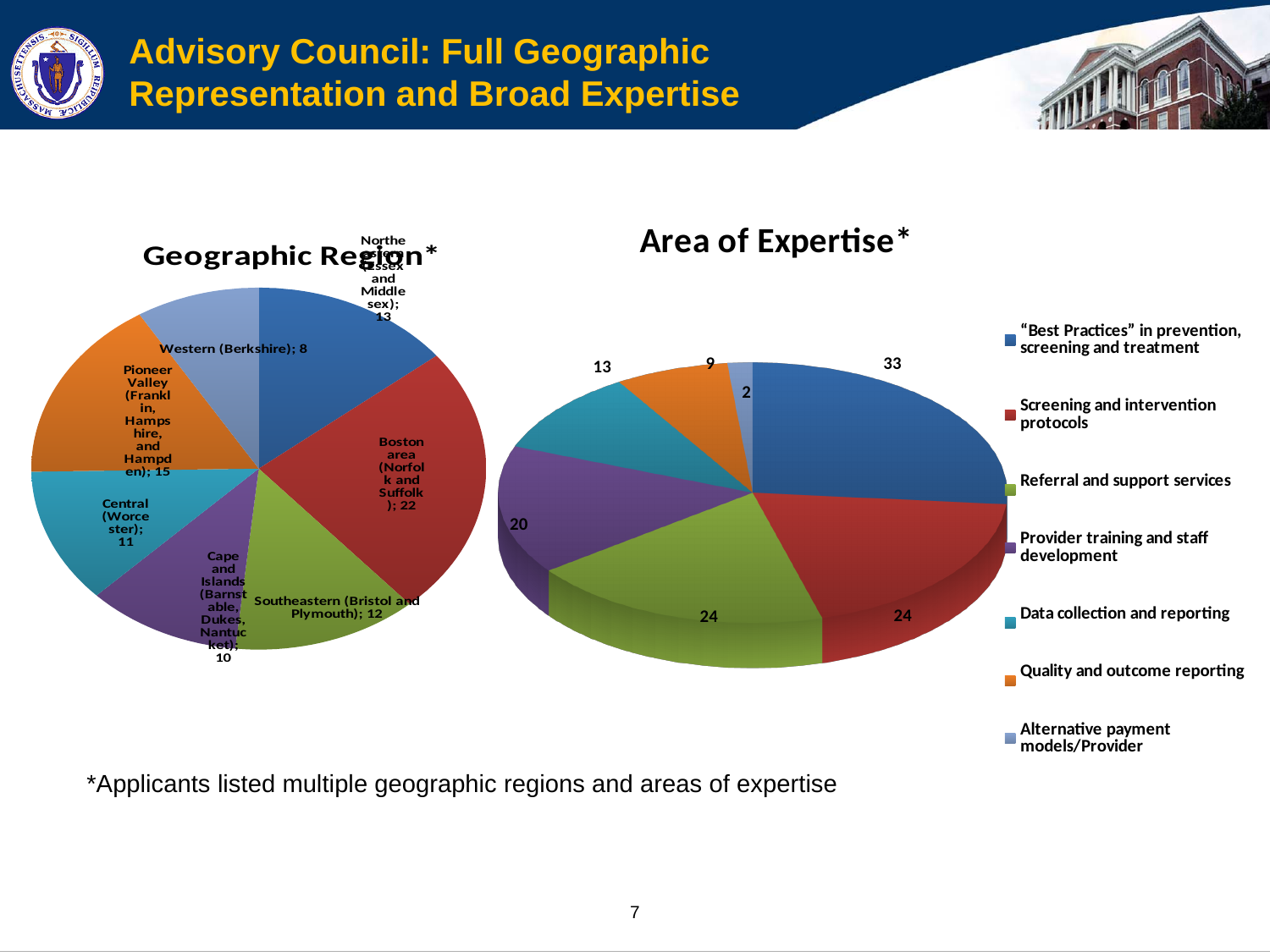
In the Geographic Region chart, how many applicants listed the Boston area (Norfolk and Suffolk)? 22 How many regions are shown in the Geographic Region pie chart? 7 In the Geographic Region chart, which region has the smallest slice? Western (Berkshire) In the Area of Expertise chart, what is the value for "Best Practices" in prevention, screening and treatment? 33 In the Area of Expertise chart, what is the difference between Provider training and staff development and Data collection and reporting? 7 In the Geographic Region chart, what is the value for Western (Berkshire)? 8 What type of chart is the Area of Expertise chart? Pie chart In the Area of Expertise chart, which area has the smallest value? Alternative payment models/Provider In the Geographic Region chart, which region has the largest slice? Boston area (Norfolk and Suffolk) In the Geographic Region chart, what is the difference between Pioneer Valley (15) and Central (Worcester) (11)? 4 How many entries does the legend of the Area of Expertise chart list? 7 In the Geographic Region chart, which is larger: Southeastern (Bristol and Plymouth) or Cape and Islands? Southeastern (Bristol and Plymouth)